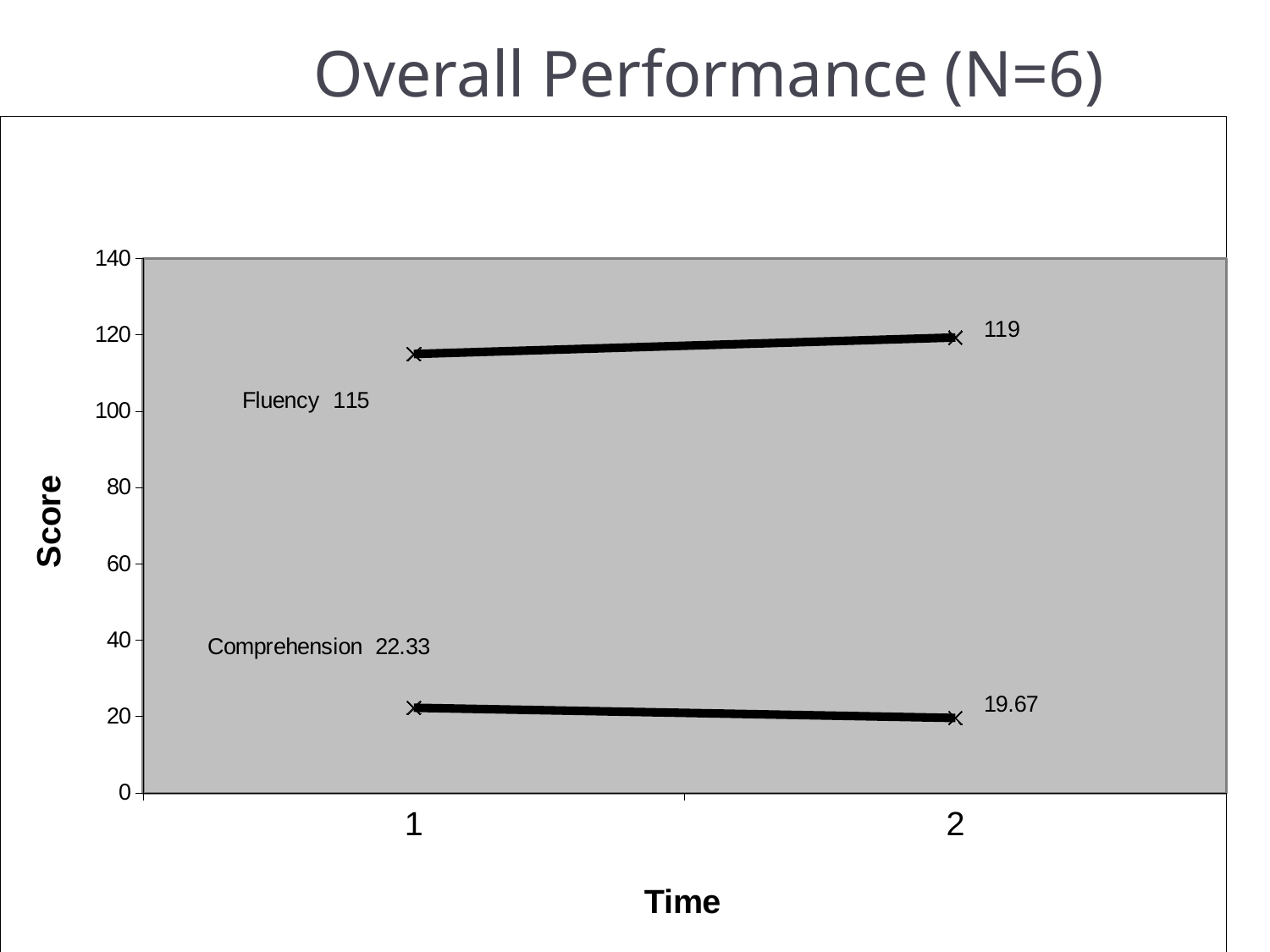
What is the Fluency score at Time 1? 115 What is the Comprehension score at Time 2? 19.67 By how much did the Fluency score change from Time 1 to Time 2? 4 By how much did the Comprehension score change from Time 1 to Time 2? 2.66 Does the Comprehension line rise or fall from Time 1 to Time 2? fall What is the title of the chart? Overall Performance (N=6) Does the Fluency line rise or fall from Time 1 to Time 2? rise What is the Comprehension score at Time 1? 22.33 What is the Fluency score at Time 2? 119 What kind of chart is shown on the slide? line chart How many time points are plotted on the x axis? 2 Which is larger, the Fluency score at Time 2 or the Fluency score at Time 1? Fluency score at Time 2